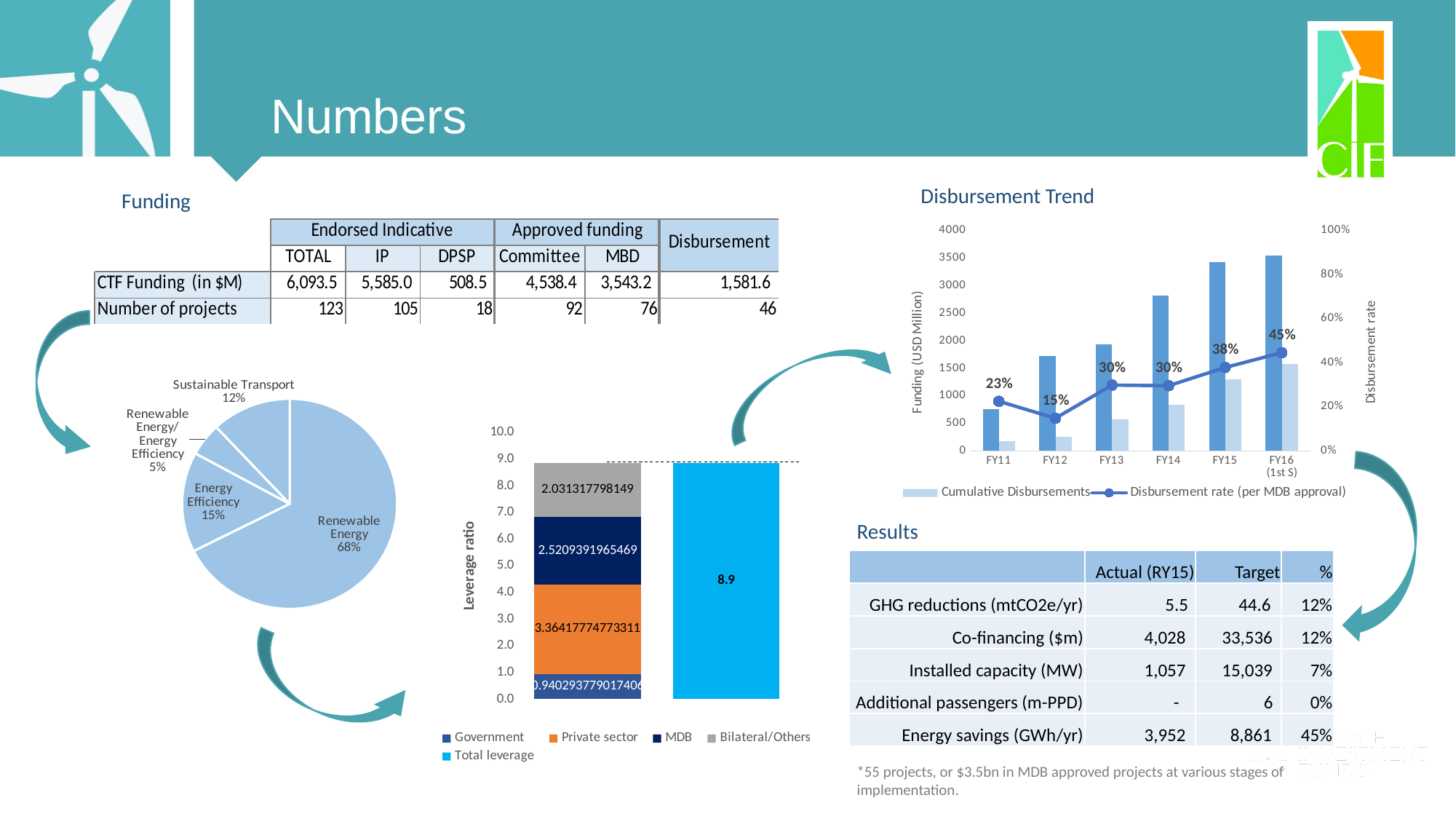
How many slices does the pie chart have? 4 In the leverage ratio chart, which segment of the stacked bar is the largest? Private sector In the leverage ratio chart, what is the value of the Total leverage bar? 8.9 In the Disbursement Trend chart, what is the disbursement rate for FY15? 38% In the Disbursement Trend chart, is the dark blue funding bar for FY15 greater or less than 3000? greater In the pie chart, what share of funding goes to Renewable Energy? 68% In the pie chart, which category has the smallest slice? Renewable Energy/Energy Efficiency In the pie chart, what is the difference in percentage points between Energy Efficiency and Sustainable Transport? 3 In the Disbursement Trend chart, which fiscal year has the lowest disbursement rate? FY12 How many series does the legend of the leverage ratio chart list? 5 In the leverage ratio chart, what is the value for Private sector? 3.36417774773311 In the leverage ratio chart, is the value for MDB larger or smaller than the value for Bilateral/Others? larger